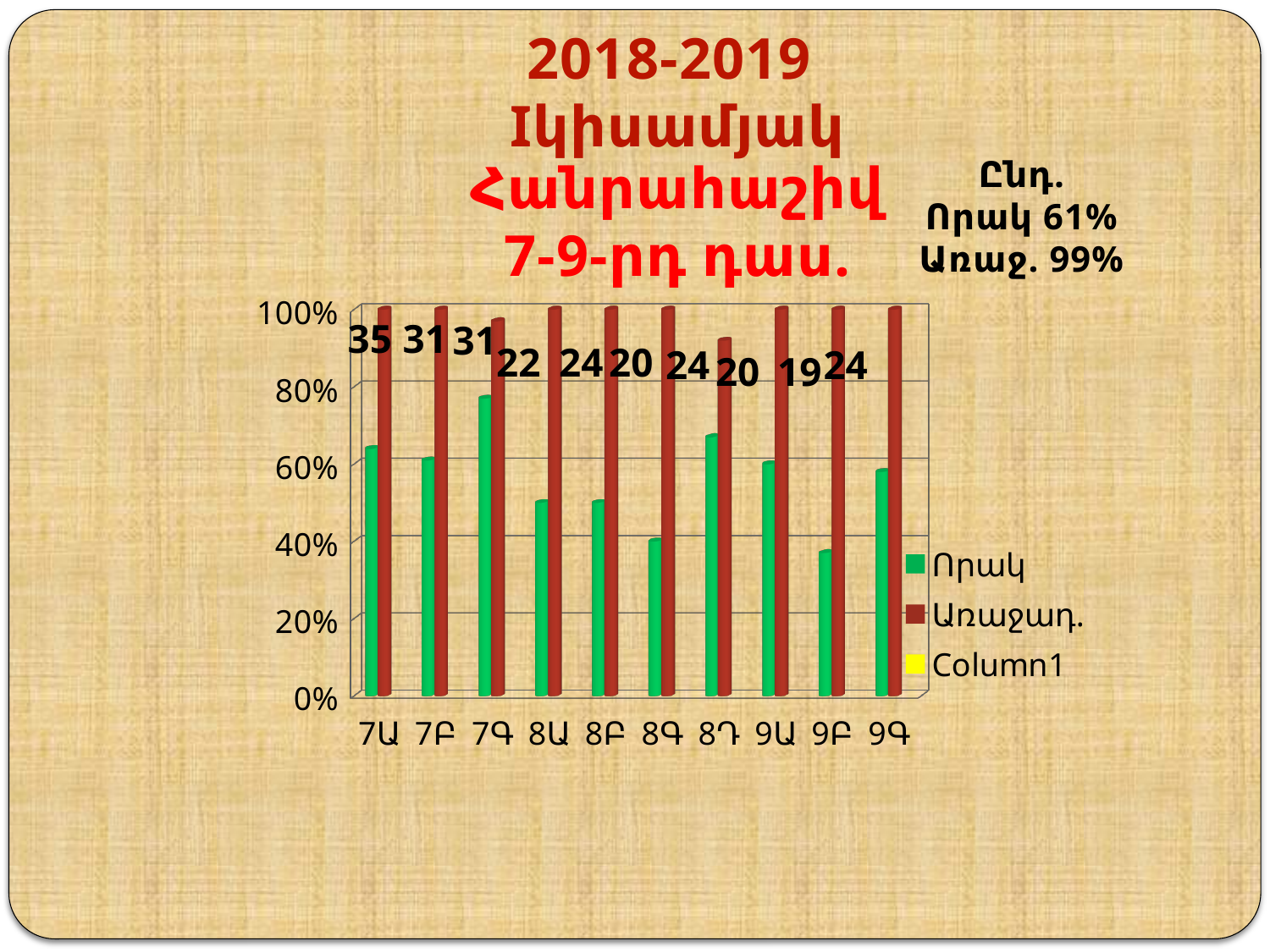
Is the green (Որակ) value for 7Գ greater or less than 60%? greater Is the green (Որակ) value for 9Բ greater or less than 40%? less Is the green (Որակ) value for 8Դ greater or less than 60%? greater How many series does the chart legend list? 3 What data label is printed above the bars for 7Ա? 35 Which category has the lowest green (Որակ) bar? 9Բ What kind of chart is shown on the slide? bar chart Which colour represents the Առաջադ. series in the legend? brown Which has the larger green (Որակ) bar, 7Գ or 8Ա? 7Գ How many categories are shown on the x axis of the chart? 10 Which category has the highest green (Որակ) bar? 7Գ What data label is printed above the bars for 9Բ? 19